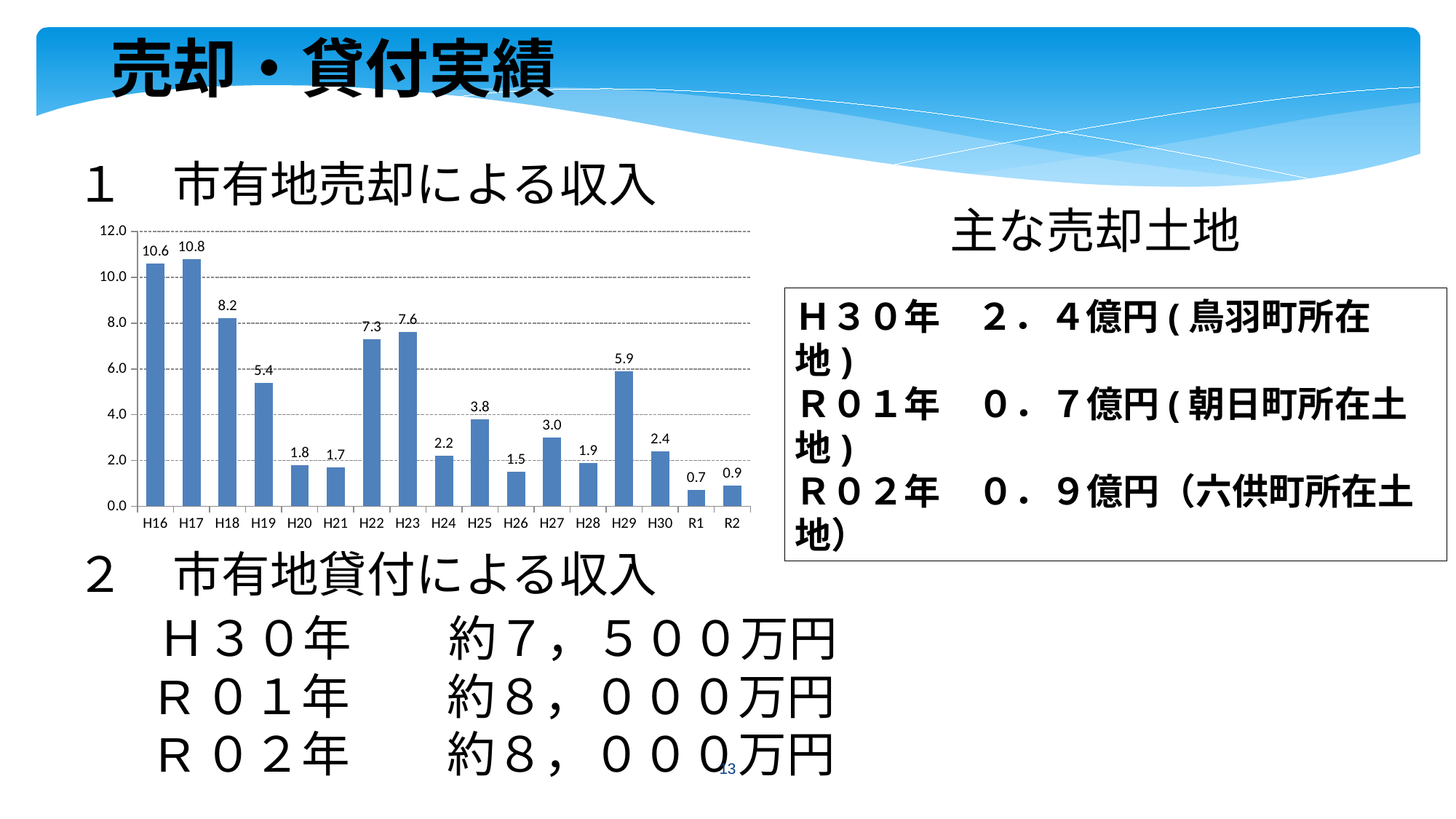
Is the value for H19 in the bar chart greater or less than 4.0? greater What is the value for H17 in the bar chart? 10.8 Which category has the lowest value in the bar chart? R1 What is the value for R2 in the bar chart? 0.9 Which is larger in the bar chart, the value for H22 or the value for H23? H23 What is the value for H29 in the bar chart? 5.9 Do the values in the bar chart rise or fall from H17 to H21? fall Which category has the highest value in the bar chart? H17 What is the difference between the values for H16 and H30 in the bar chart? 8.2 What kind of chart is shown on the slide? bar chart How many categories are shown on the x axis of the bar chart? 17 What is the maximum value shown on the y axis of the bar chart? 12.0